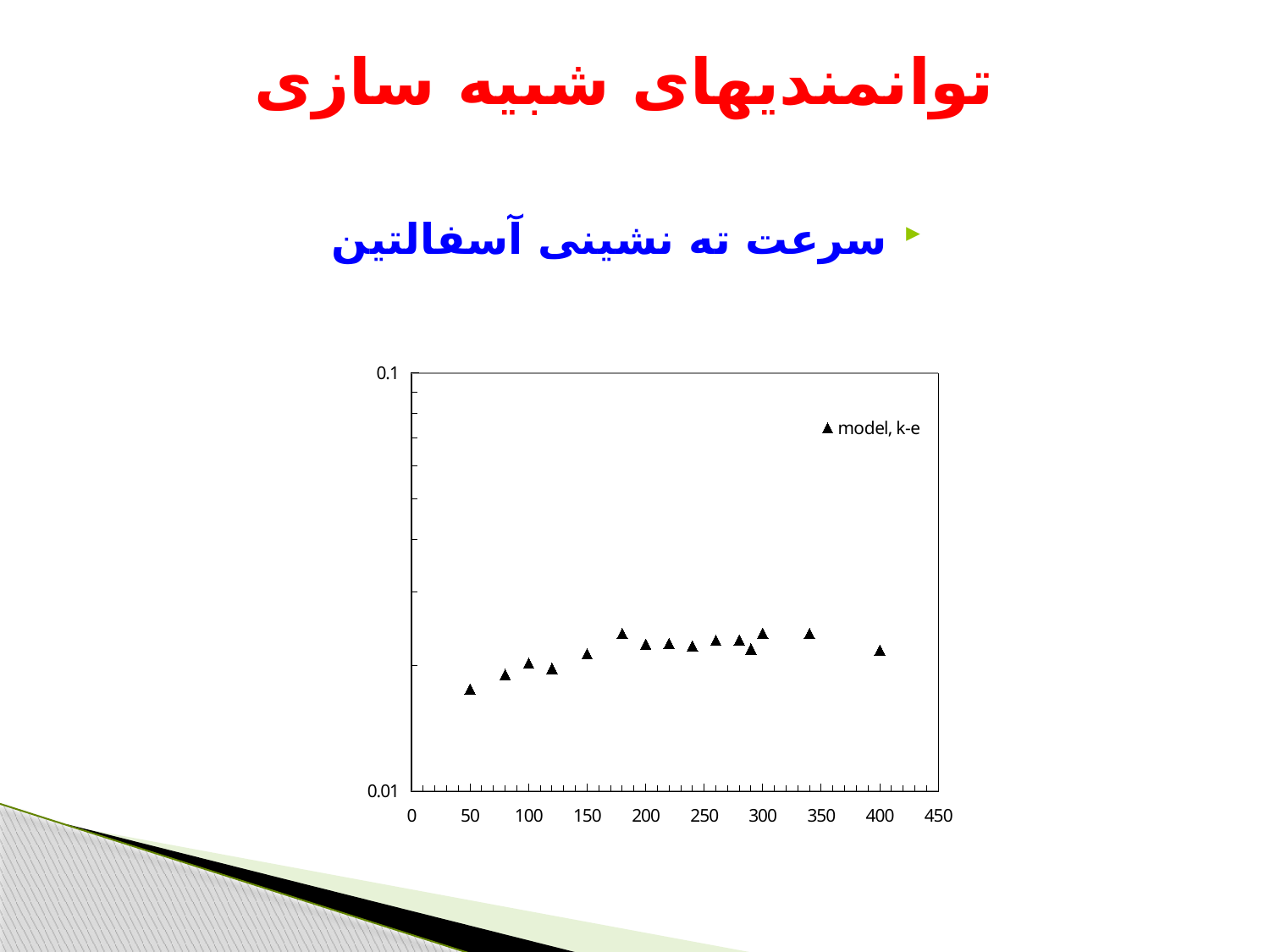
What are the lowest and highest labelled values on the y axis? 0.01 and 0.1 What kind of chart is shown on the slide? Scatter plot Which has the larger plotted value: the point at x = 50 or the point at x = 400? x = 400 How many series does the chart legend list? 1 Which has the larger plotted value: the point at x = 50 or the point at x = 150? x = 150 At which x value is the lowest plotted point? 50 How many data points are plotted in the chart? 15 Do the plotted values rise or fall between x = 50 and x = 180? rise Is the plotted value at x = 50 greater or less than 0.01? greater What is the maximum value shown on the x axis? 450 Is the plotted value at x = 340 greater or less than 0.1? less What is the name of the series shown in the chart legend? model, k-e